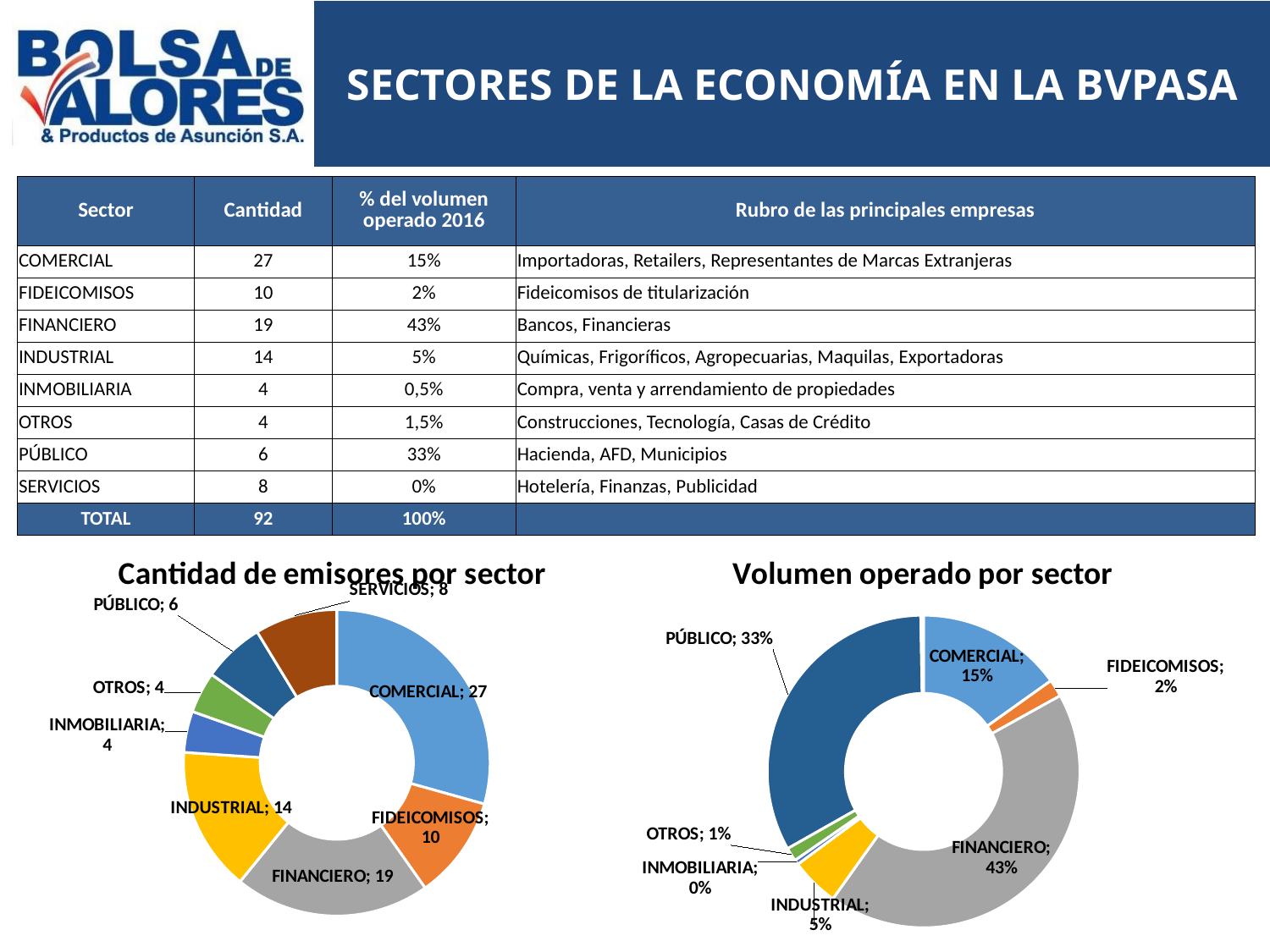
In the 'Volumen operado por sector' chart, which is larger, INDUSTRIAL or FIDEICOMISOS? INDUSTRIAL In the 'Volumen operado por sector' chart, what is the share for PÚBLICO? 33% How many sectors are shown in the 'Cantidad de emisores por sector' chart? 8 In the 'Volumen operado por sector' chart, which sector has the largest share? FINANCIERO In the 'Cantidad de emisores por sector' chart, which is larger, FIDEICOMISOS or SERVICIOS? FIDEICOMISOS In the 'Volumen operado por sector' chart, what is the share for FINANCIERO? 43% In the 'Cantidad de emisores por sector' chart, which sector has the highest value? COMERCIAL In the 'Cantidad de emisores por sector' chart, what is the value for FINANCIERO? 19 What kind of chart is 'Cantidad de emisores por sector'? Doughnut chart In the 'Volumen operado por sector' chart, what is the difference between FINANCIERO and COMERCIAL? 28% In the 'Cantidad de emisores por sector' chart, what is the value for COMERCIAL? 27 In the 'Cantidad de emisores por sector' chart, what is the difference between COMERCIAL and INDUSTRIAL? 13